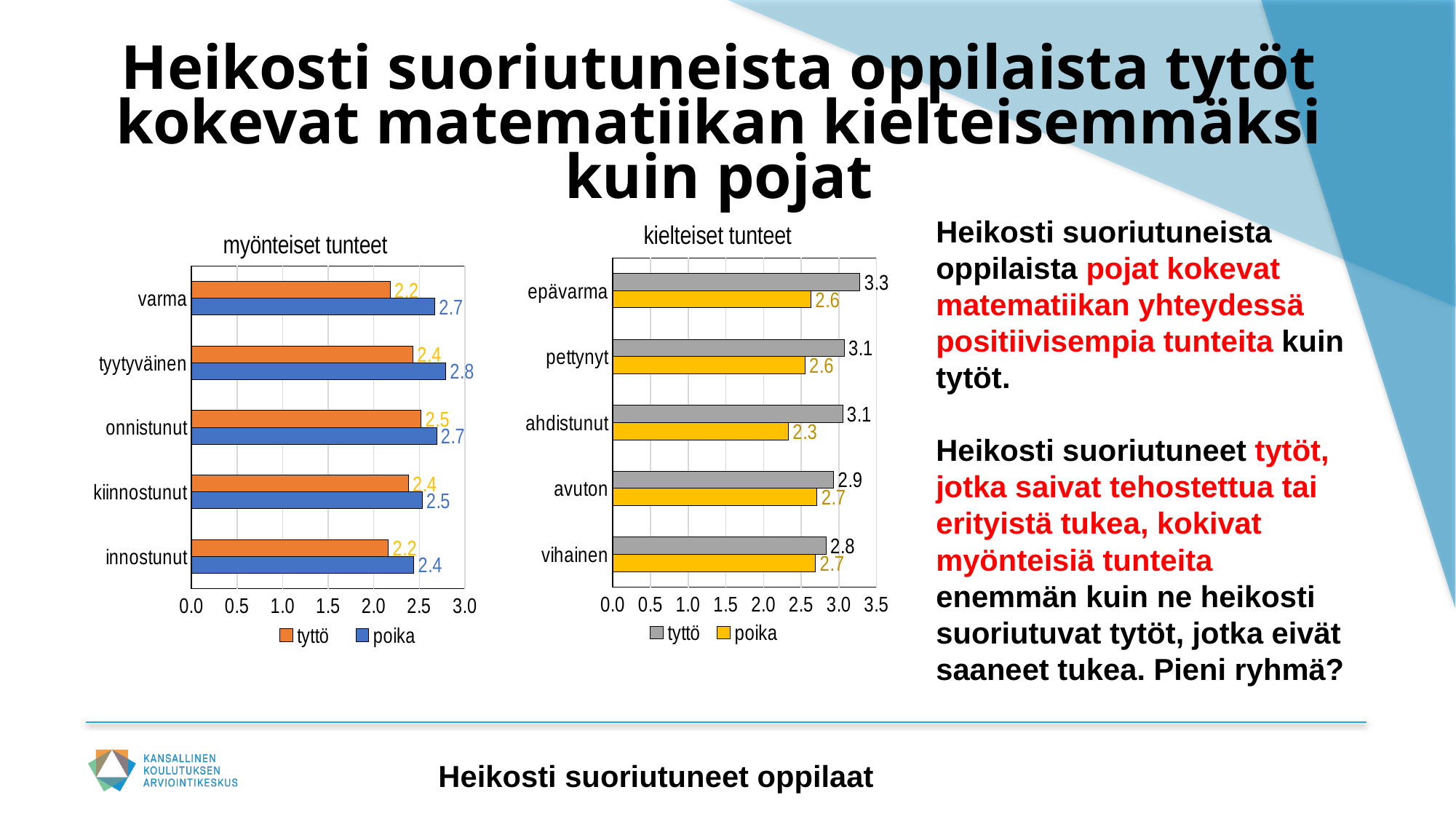
In the 'kielteiset tunteet' chart, what is the value for tyttö for 'epävarma'? 3.3 In the 'kielteiset tunteet' chart, what is the difference between the tyttö and poika values for 'ahdistunut'? 0.8 In the 'kielteiset tunteet' chart, what is the value for poika for 'ahdistunut'? 2.3 What type of chart is the 'kielteiset tunteet' chart? bar chart In the 'kielteiset tunteet' chart, which category has the lowest value for poika? ahdistunut In the 'myönteiset tunteet' chart, which is larger for 'onnistunut': the tyttö value or the poika value? poika In the 'myönteiset tunteet' chart, what is the difference between the poika and tyttö values for 'varma'? 0.5 In the 'kielteiset tunteet' chart, which category has the highest value for tyttö? epävarma In the 'myönteiset tunteet' chart, what is the value for poika for 'tyytyväinen'? 2.8 In the 'myönteiset tunteet' chart, what is the value for tyttö for 'innostunut'? 2.2 How many series does the legend of the 'myönteiset tunteet' chart list? 2 How many categories are shown in the 'kielteiset tunteet' chart? 5